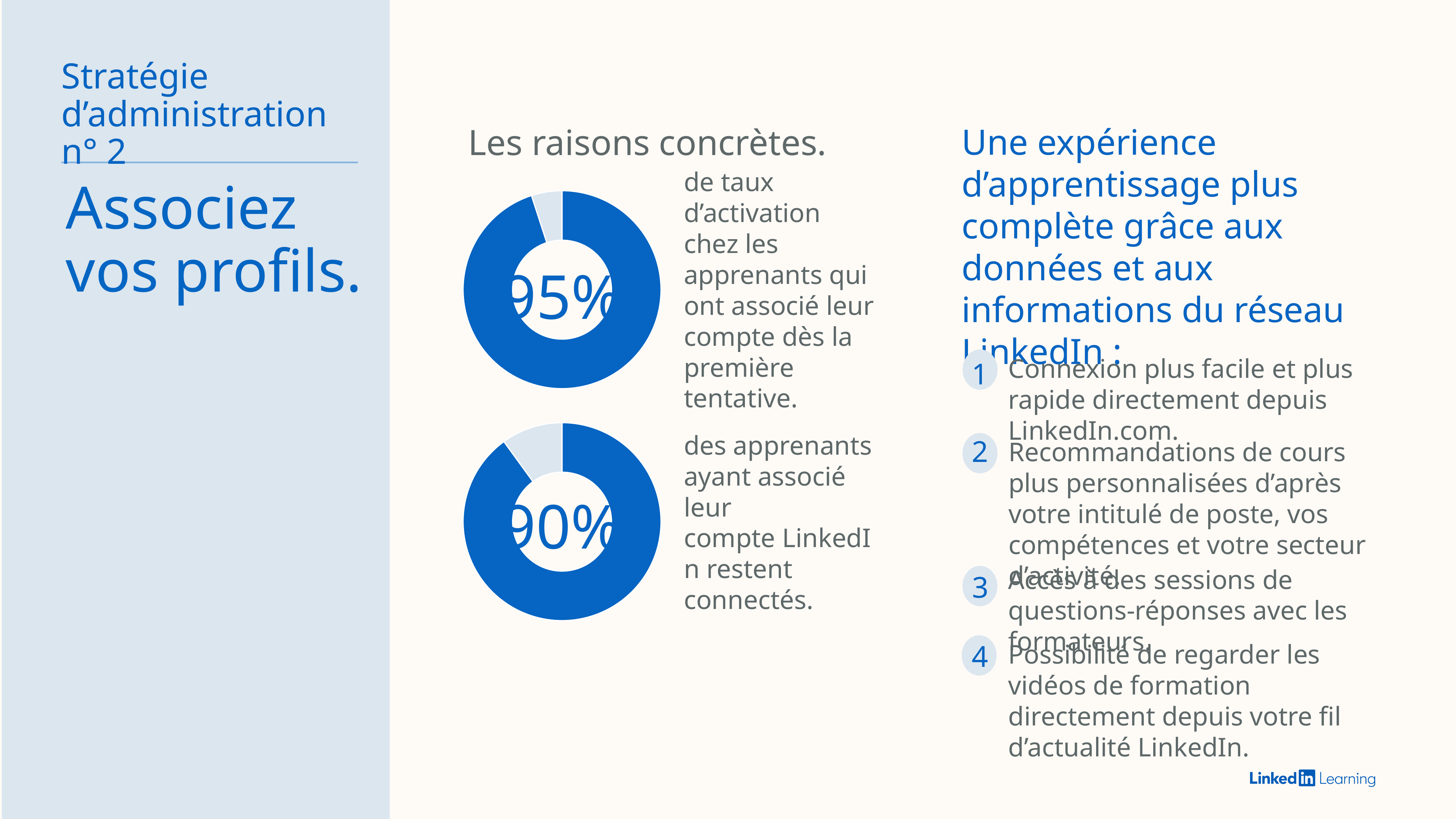
What percentage is shown in the centre of the bottom donut chart? 90% Is the value shown in the top donut chart greater or less than 90%? greater What is the difference in percentage points between the top donut chart (95%) and the bottom donut chart (90%)? 5 percentage points According to the text next to the bottom donut chart, what share of learners who linked their LinkedIn account stay connected? 90% How many donut charts are on the slide? 2 What is the heading above the two donut charts? Les raisons concrètes. Is the value shown in the bottom donut chart greater or less than 50%? greater What percentage is shown in the centre of the top donut chart? 95% What kind of chart is used to show the 95% figure? Donut chart Which donut chart shows the larger percentage, the top one or the bottom one? The top one According to the text next to the top donut chart, what is the activation rate among learners who linked their account on the first attempt? 95% What colour is the filled portion of the donut charts? Blue